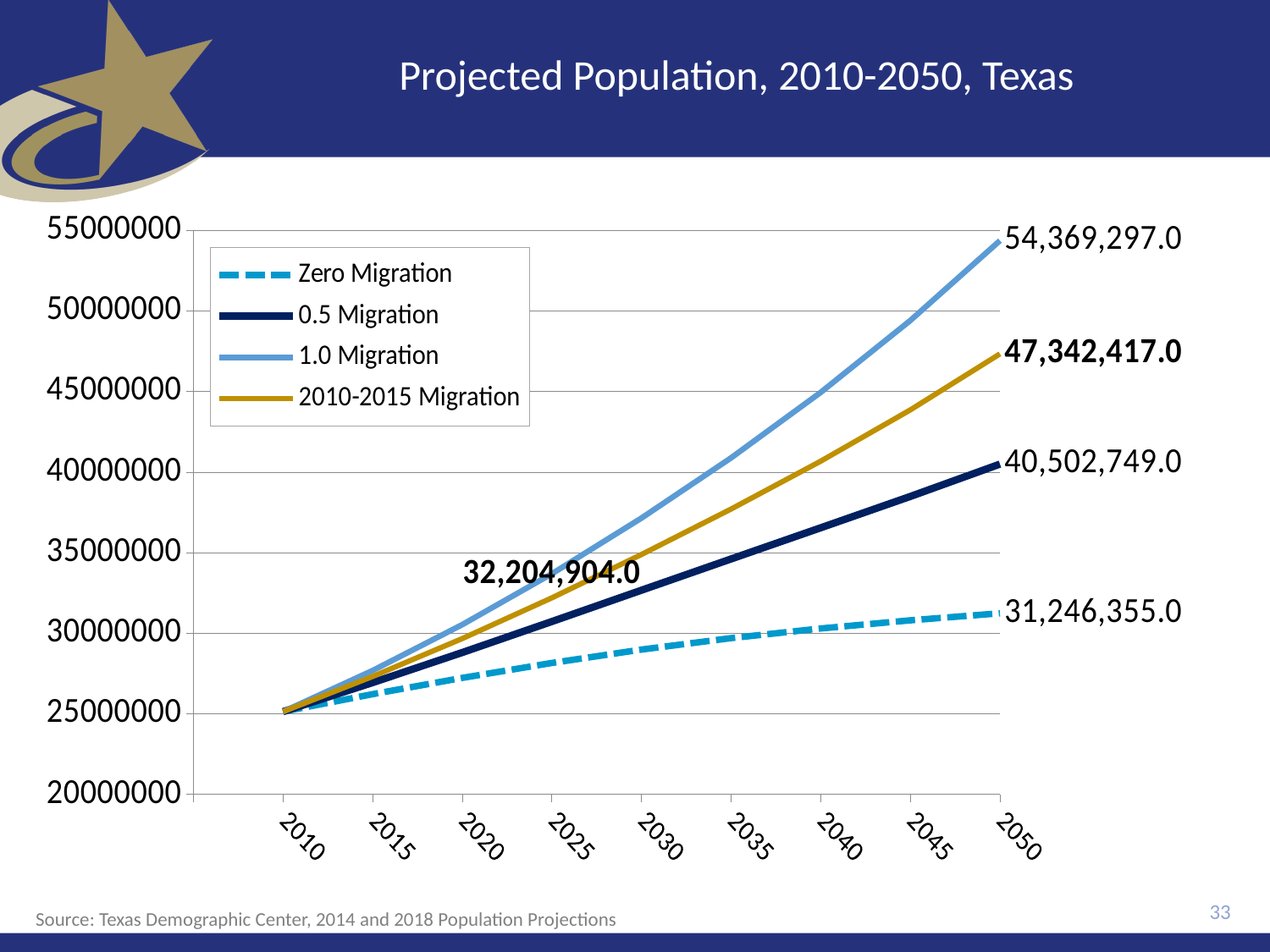
What is the projected population for the 1.0 Migration scenario in 2050? 54,369,297.0 Which scenario has the highest projected population in 2050? 1.0 Migration How many years are labelled on the x axis? 9 What is the projected population for the 2010-2015 Migration scenario in 2050? 47,342,417.0 In 2050, which is larger: the 0.5 Migration projection or the 2010-2015 Migration projection? 2010-2015 Migration What is the difference between the 1.0 Migration and Zero Migration projections in 2050? 23,122,942.0 Which scenario has the lowest projected population in 2050? Zero Migration What kind of chart is shown on the slide? line chart What is the projected population for the Zero Migration scenario in 2050? 31,246,355.0 How many series does the legend list? 4 Is the 1.0 Migration value in 2030 greater or less than 35000000? greater What is the projected population for the 0.5 Migration scenario in 2050? 40,502,749.0